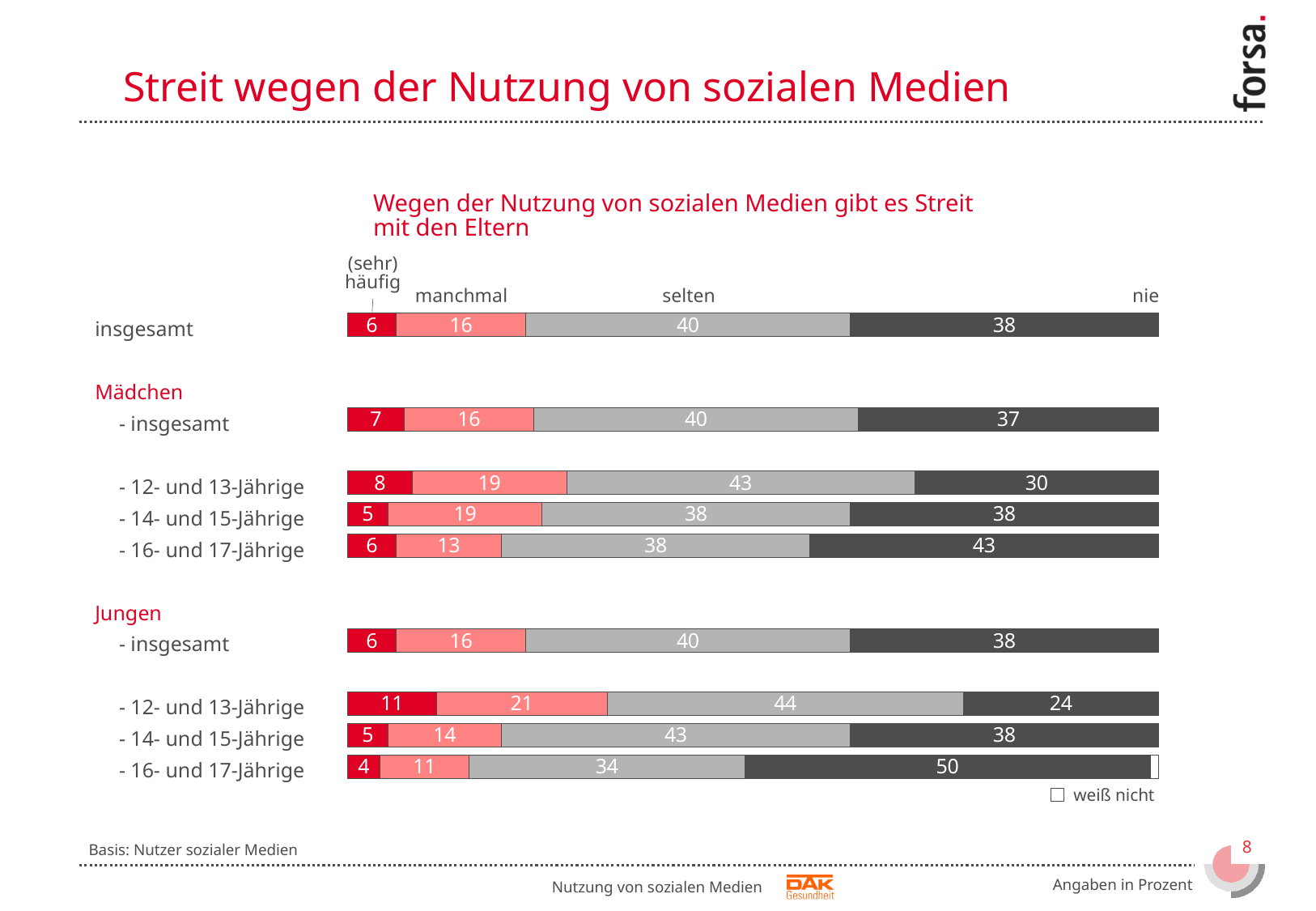
What is the value for "manchmal" for Mädchen 16- und 17-Jährige? 13 In what unit are the values given, according to the note at the bottom right? Prozent How many groups (bars) are shown in the chart? 9 What is the difference between the "nie" values for Jungen 12- und 13-Jährige and Jungen 16- und 17-Jährige? 26 Which is larger: the "manchmal" value for Mädchen 12- und 13-Jährige or for Jungen 12- und 13-Jährige? Jungen 12- und 13-Jährige What is the value for "nie" for Jungen 16- und 17-Jährige? 50 What is the value for "selten" for Mädchen 12- und 13-Jährige? 43 What is the value for "(sehr) häufig" for Jungen 12- und 13-Jährige? 11 Which group has the lowest value for "(sehr) häufig"? Jungen 16- und 17-Jährige Which group has the highest value for "nie"? Jungen 16- und 17-Jährige What kind of chart is shown on the slide? Stacked bar chart How many response categories does the chart's legend list? 5